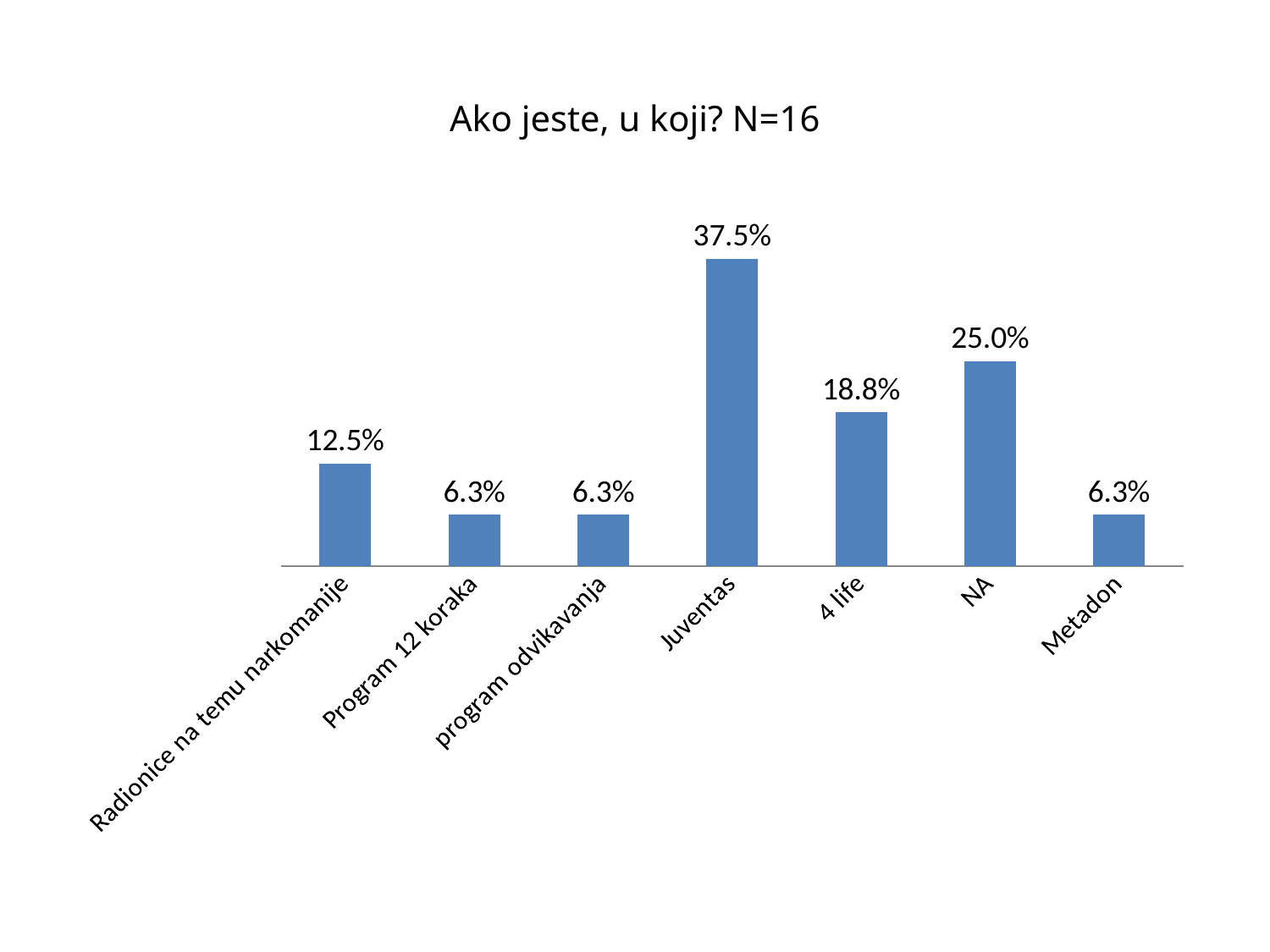
What is the value for 4 life? 18.8% Which is larger, the value for 4 life or the value for Radionice na temu narkomanije? 4 life What kind of chart is shown on the slide? Bar chart What is the value for Radionice na temu narkomanije? 12.5% What is the title of the chart? Ako jeste, u koji? N=16 What is the difference between the values for Juventas and NA? 12.5% What is the value for NA? 25.0% What is the difference between the values for NA and 4 life? 6.2% What is the value for Juventas? 37.5% What is the value for Metadon? 6.3% Which category has the highest value? Juventas How many categories are shown on the x axis? 7